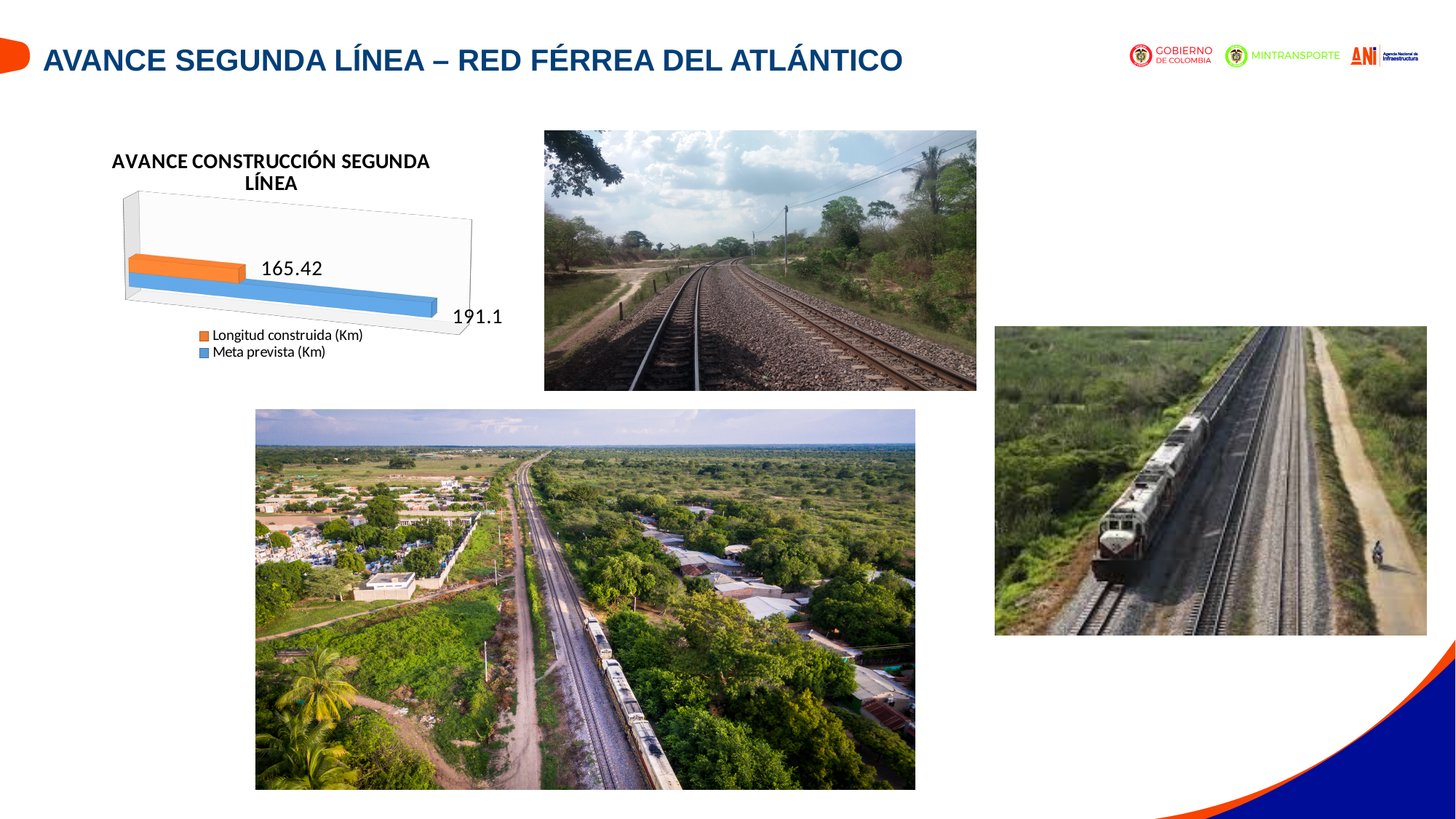
What colour is the bar for Longitud construida (Km)? Orange What is the difference between Meta prevista (Km) and Longitud construida (Km)? 25.68 What is the value for Meta prevista (Km) in the chart? 191.1 Which series has the largest value in the chart? Meta prevista (Km) How many bars are plotted in the chart? 2 Which series has the larger value, Longitud construida (Km) or Meta prevista (Km)? Meta prevista (Km) What type of chart is shown on the slide? Bar chart Which series has the smallest value in the chart? Longitud construida (Km) How many series does the chart legend list? 2 What is the title of the chart on the slide? AVANCE CONSTRUCCIÓN SEGUNDA LÍNEA What is the value for Longitud construida (Km) in the chart? 165.42